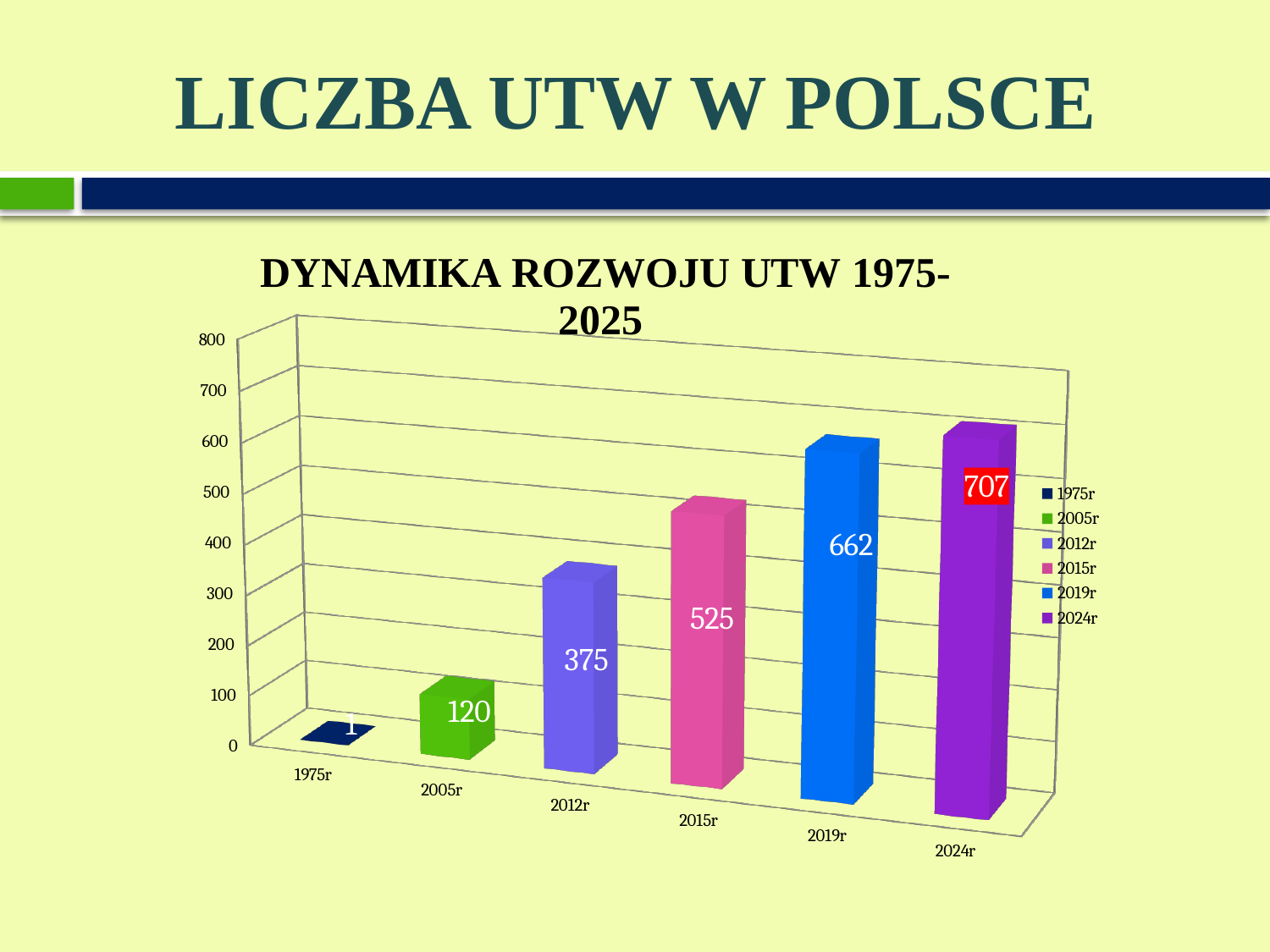
Do the values rise or fall from 1975r to 2024r? rise What is the difference between the values for 2024r and 2019r? 45 Which category has the highest value? 2024r How many entries does the legend list? 6 Which category has the lowest value? 1975r What is the value for 2024r? 707 What is the value for 2005r? 120 What kind of chart is this? bar chart Which is larger, the value for 2019r or the value for 2015r? 2019r What is the value for 2012r? 375 What is the difference between the values for 2015r and 2012r? 150 How many categories are shown on the x axis? 6